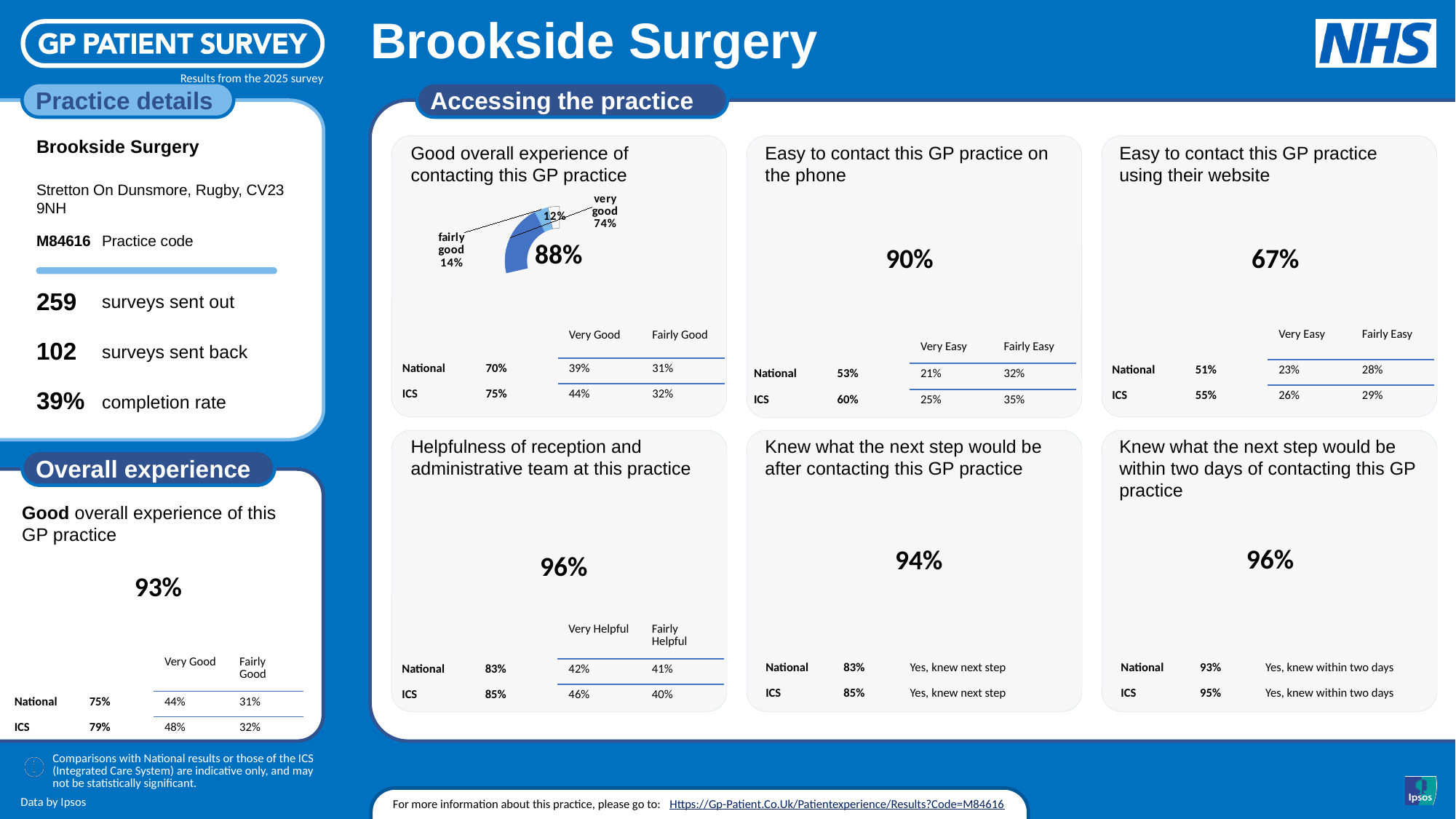
In the 'Good overall experience of contacting this GP practice' chart, what percentage is labelled 'very good'? 74% What value is printed in the centre of the 'Good overall experience of contacting this GP practice' doughnut chart? 88% In the 'Good overall experience of contacting this GP practice' chart, what percentage is labelled 'fairly good'? 14% In the 'Good overall experience of contacting this GP practice' chart, what is the difference between the 'very good' and 'fairly good' percentages? 60% How many slices does the 'Good overall experience of contacting this GP practice' doughnut chart have? 3 In the 'Good overall experience of contacting this GP practice' chart, what do the 'very good' and 'fairly good' slices add up to? 88% In the 'Good overall experience of contacting this GP practice' chart, which labelled slice is the largest? very good What is the title of the panel containing the doughnut chart? Good overall experience of contacting this GP practice In the 'Good overall experience of contacting this GP practice' chart, what percentage is shown for the smallest slice? 12% In the 'Good overall experience of contacting this GP practice' chart, which is larger: 'very good' or 'fairly good'? very good What kind of chart is shown in the 'Good overall experience of contacting this GP practice' panel? doughnut chart